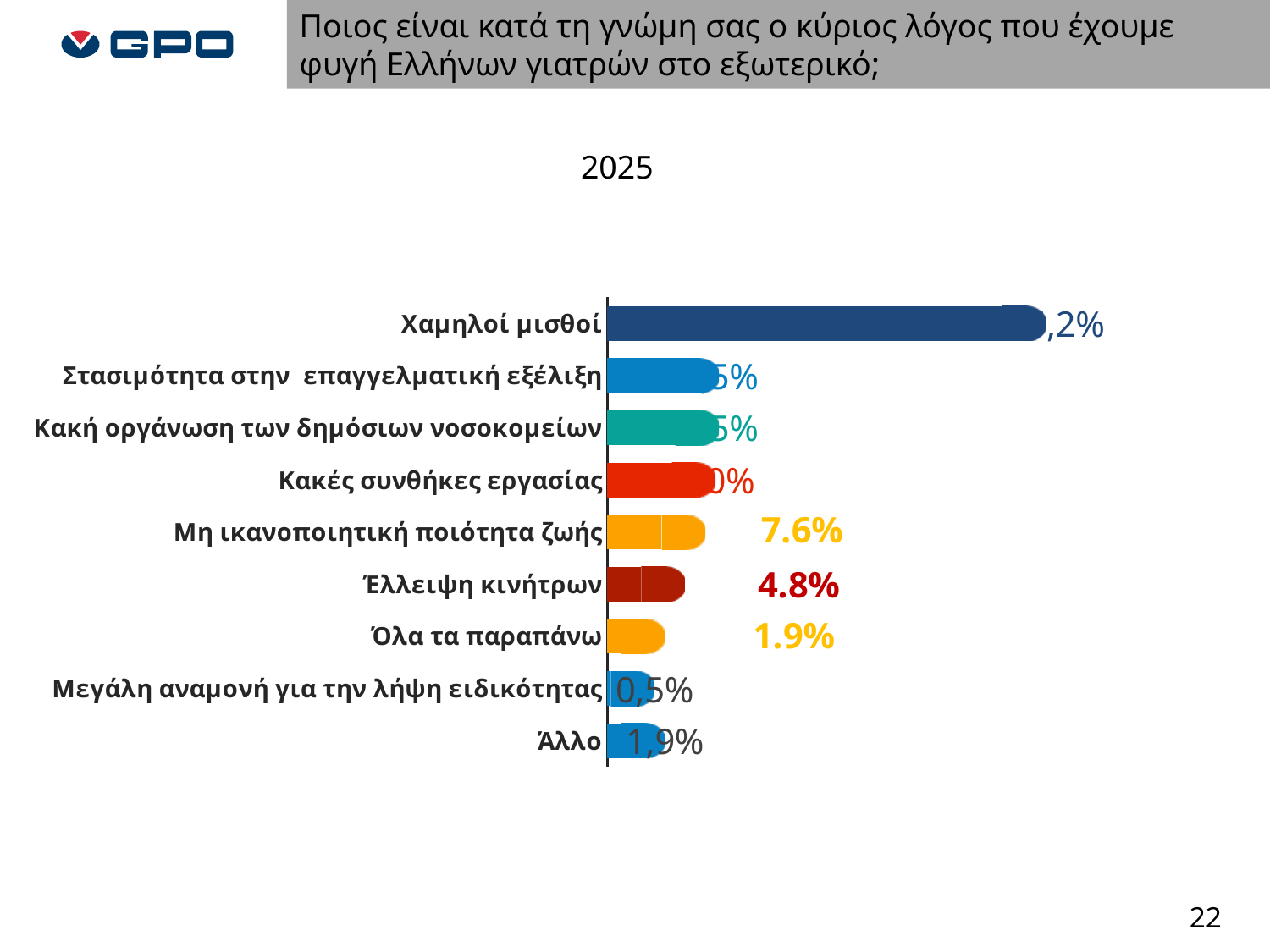
What is the value for Μη ικανοποιητική ποιότητα ζωής? 7.6% What kind of chart is shown on the slide? bar chart What year is shown as the chart's title? 2025 What is the value for Όλα τα παραπάνω? 1.9% What is the value for Άλλο? 1,9% What is the value for Έλλειψη κινήτρων? 4.8% Which category has the highest value? Χαμηλοί μισθοί What is the difference between the values for Μη ικανοποιητική ποιότητα ζωής and Έλλειψη κινήτρων? 2.8% How many categories are plotted in the chart? 9 Which category has the lowest value? Μεγάλη αναμονή για την λήψη ειδικότητας Which is larger, the value for Μη ικανοποιητική ποιότητα ζωής or the value for Έλλειψη κινήτρων? Μη ικανοποιητική ποιότητα ζωής What is the value for Μεγάλη αναμονή για την λήψη ειδικότητας? 0,5%